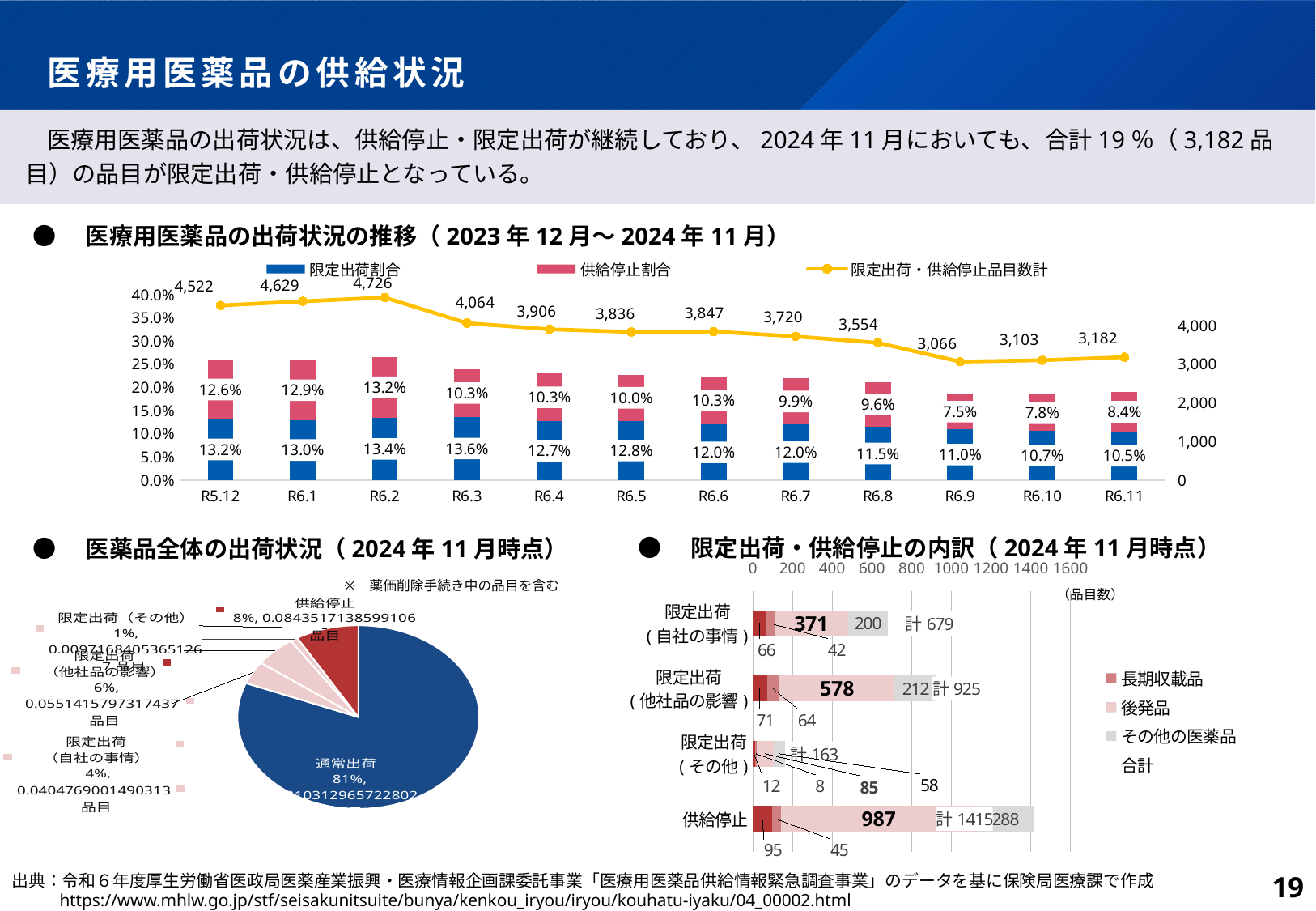
In the bottom-left pie chart (医薬品全体の出荷状況), what share does 通常出荷 have? 81% In the bottom-right chart (限定出荷・供給停止の内訳), what is the 後発品 value for 供給停止? 987 In the top chart (医療用医薬品の出荷状況の推移), what is the 限定出荷・供給停止品目数計 value for R6.11? 3,182 In the top chart (医療用医薬品の出荷状況の推移), which month has the lowest 限定出荷・供給停止品目数計? R6.9 In the top chart (医療用医薬品の出荷状況の推移), how many months are shown on the x axis? 12 In the top chart (医療用医薬品の出荷状況の推移), how many series does the legend list? 3 In the top chart (医療用医薬品の出荷状況の推移), what is the difference in 限定出荷・供給停止品目数計 between R6.2 and R6.11? 1,544 In the top chart (医療用医薬品の出荷状況の推移), which month has the highest 限定出荷・供給停止品目数計? R6.2 In the top chart (医療用医薬品の出荷状況の推移), does the 限定出荷・供給停止品目数計 line generally rise or fall from R6.2 to R6.9? fall In the top chart (医療用医薬品の出荷状況の推移), what is the 限定出荷割合 value for R6.3? 13.6% In the bottom-right chart (限定出荷・供給停止の内訳), what is the total (計) for 限定出荷（他社品の影響）? 925 In the top chart (医療用医薬品の出荷状況の推移), what is the 供給停止割合 value for R6.9? 7.5%